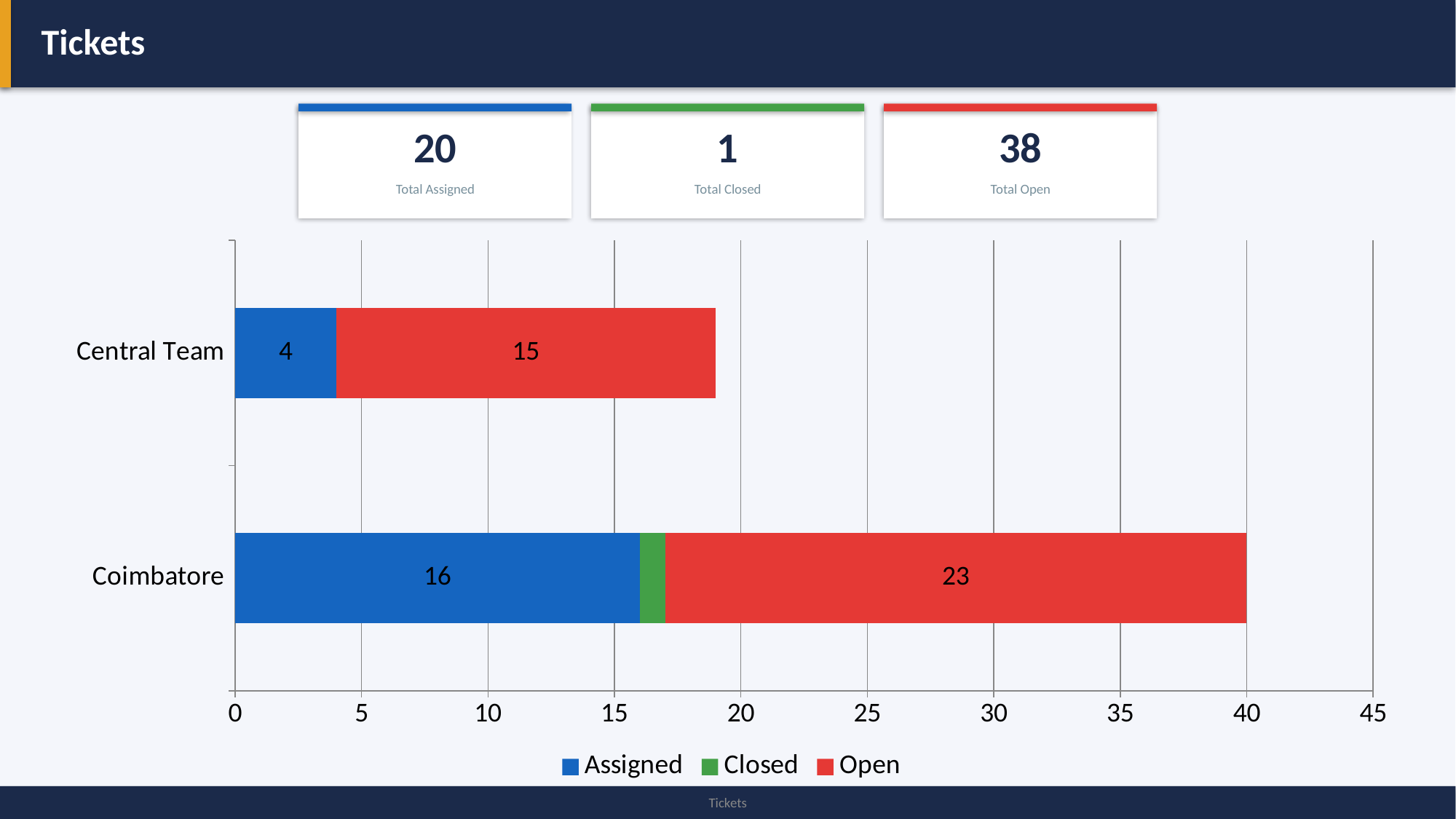
What is the Open value for Central Team? 15 What is the Assigned value for Central Team? 4 What is the Assigned value for Coimbatore? 16 Which category has more Open tickets, Coimbatore or Central Team? Coimbatore How many categories are shown on the chart? 2 How many series does the legend list? 3 What kind of chart is shown on the slide? Stacked bar chart How many more Open tickets does Coimbatore have than Central Team? 8 What is the Open value for Coimbatore? 23 Which category has the highest Assigned value? Coimbatore Is the total length of the Coimbatore bar greater or less than 30? greater What is the difference between the Assigned values for Coimbatore and Central Team? 12